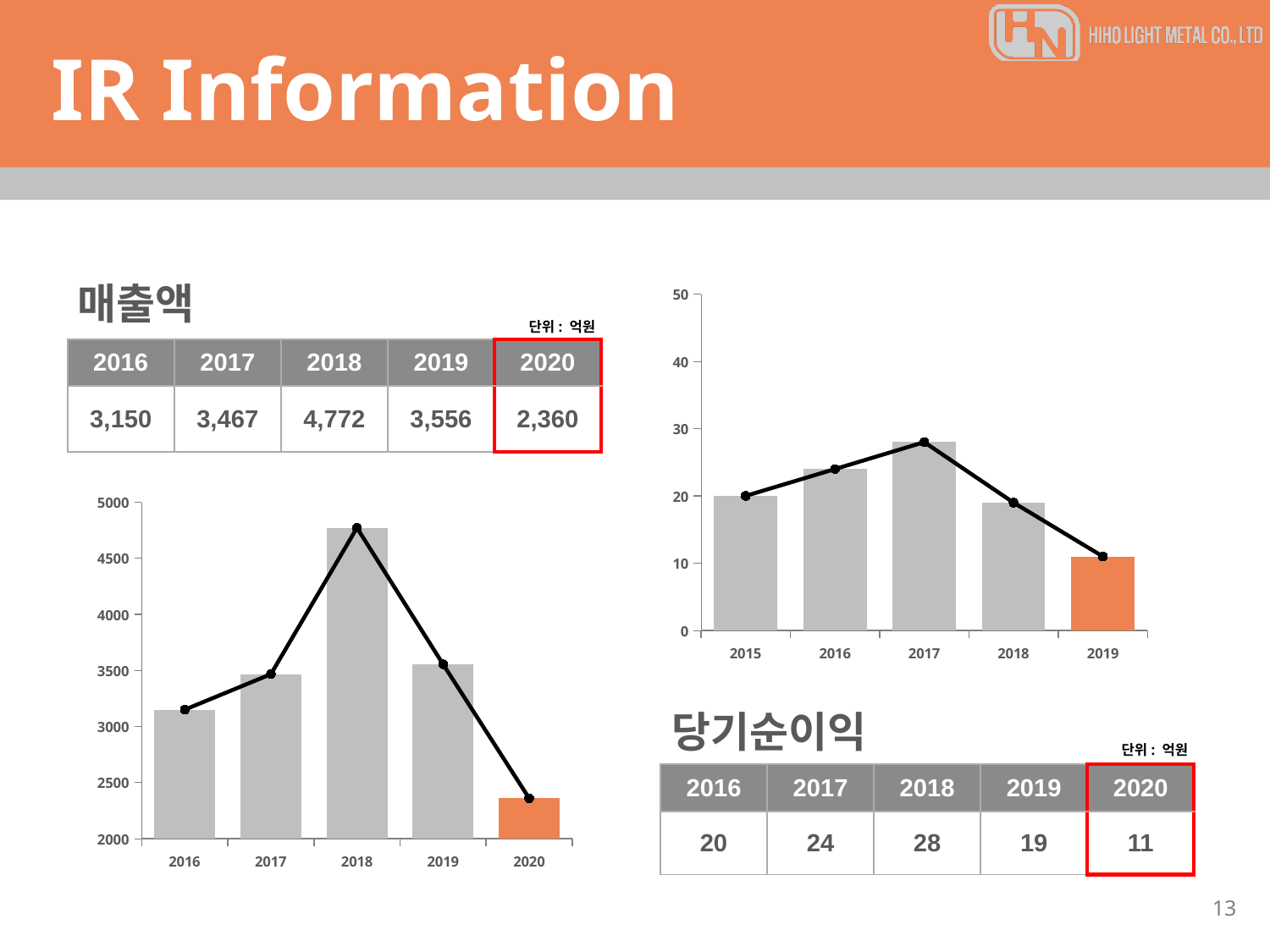
In the left chart (매출액), do the values rise or fall from 2018 to 2020? fall In the left chart (매출액), which year has the highest bar? 2018 In the left chart (매출액), what is the value for 2018? 4,772 In the left chart (매출액), is the value for 2020 greater or less than 2500? less In the left chart (매출액), which year has the lowest bar? 2020 In the left chart (매출액), which year's bar is coloured orange? 2020 In the left chart (매출액), what is the difference between the 2018 and 2019 values? 1,216 In the left chart (매출액), which is larger, the value for 2017 or the value for 2019? 2019 In the right chart (above 당기순이익), which x-axis year has the highest bar? 2017 In the right chart (above 당기순이익), is the bar labelled 2015 greater or less than 30? less In the left chart (매출액), how many years are shown on the x axis? 5 What kind of chart is the left chart under 매출액? bar chart with a line overlay